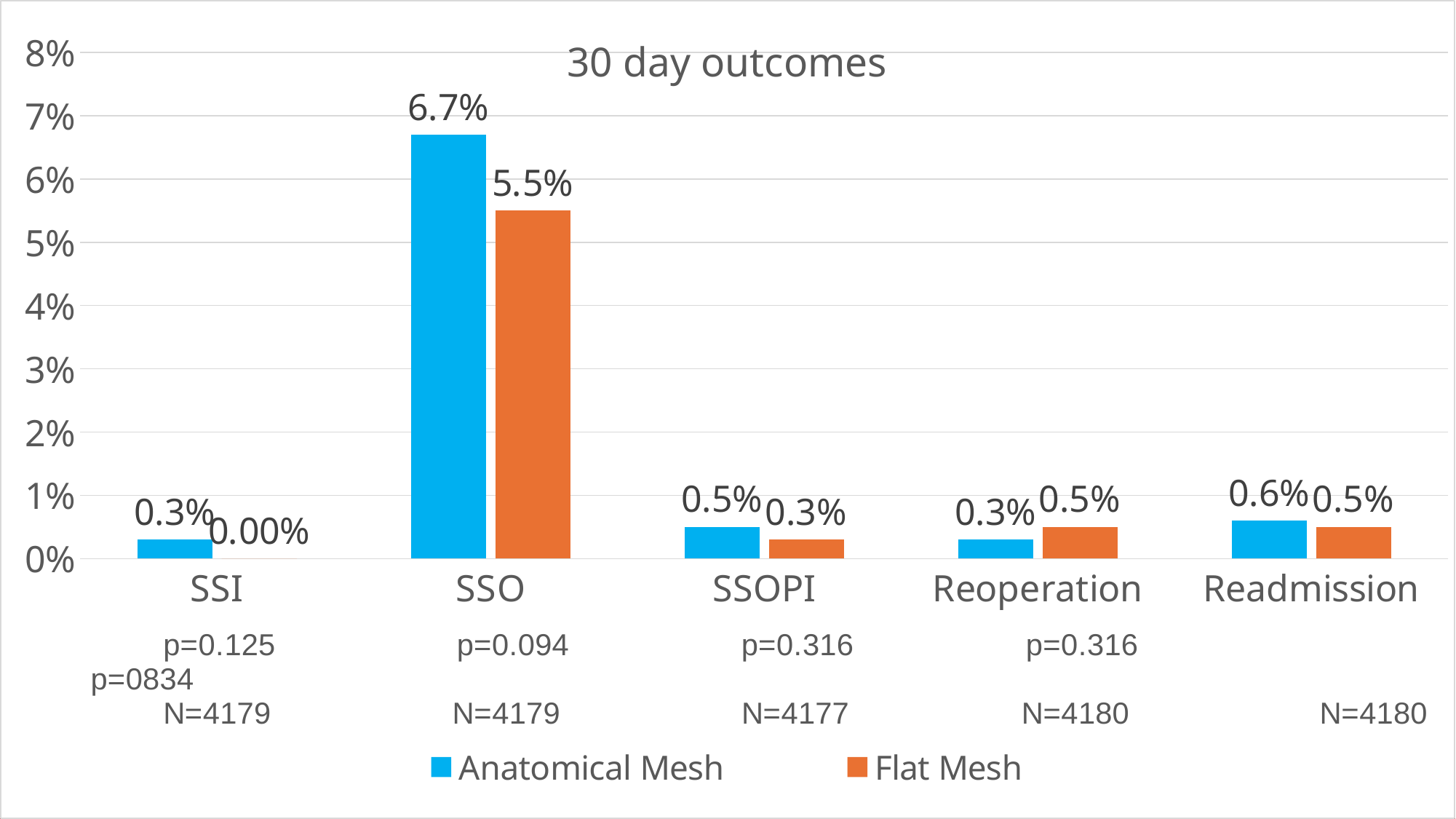
Which category has the lowest Flat Mesh value? SSI What is the Anatomical Mesh value for SSO? 6.7% What kind of chart is this? Bar chart What is the Flat Mesh value for SSO? 5.5% What is the title of the chart? 30 day outcomes How many categories are shown on the x axis? 5 What is the Flat Mesh value for SSI? 0.00% What is the difference between the Anatomical Mesh and Flat Mesh values for SSO? 1.2% For Reoperation, which series has the larger value, Anatomical Mesh or Flat Mesh? Flat Mesh How many series does the legend list? 2 Which category has the highest Anatomical Mesh value? SSO What is the Anatomical Mesh value for Readmission? 0.6%